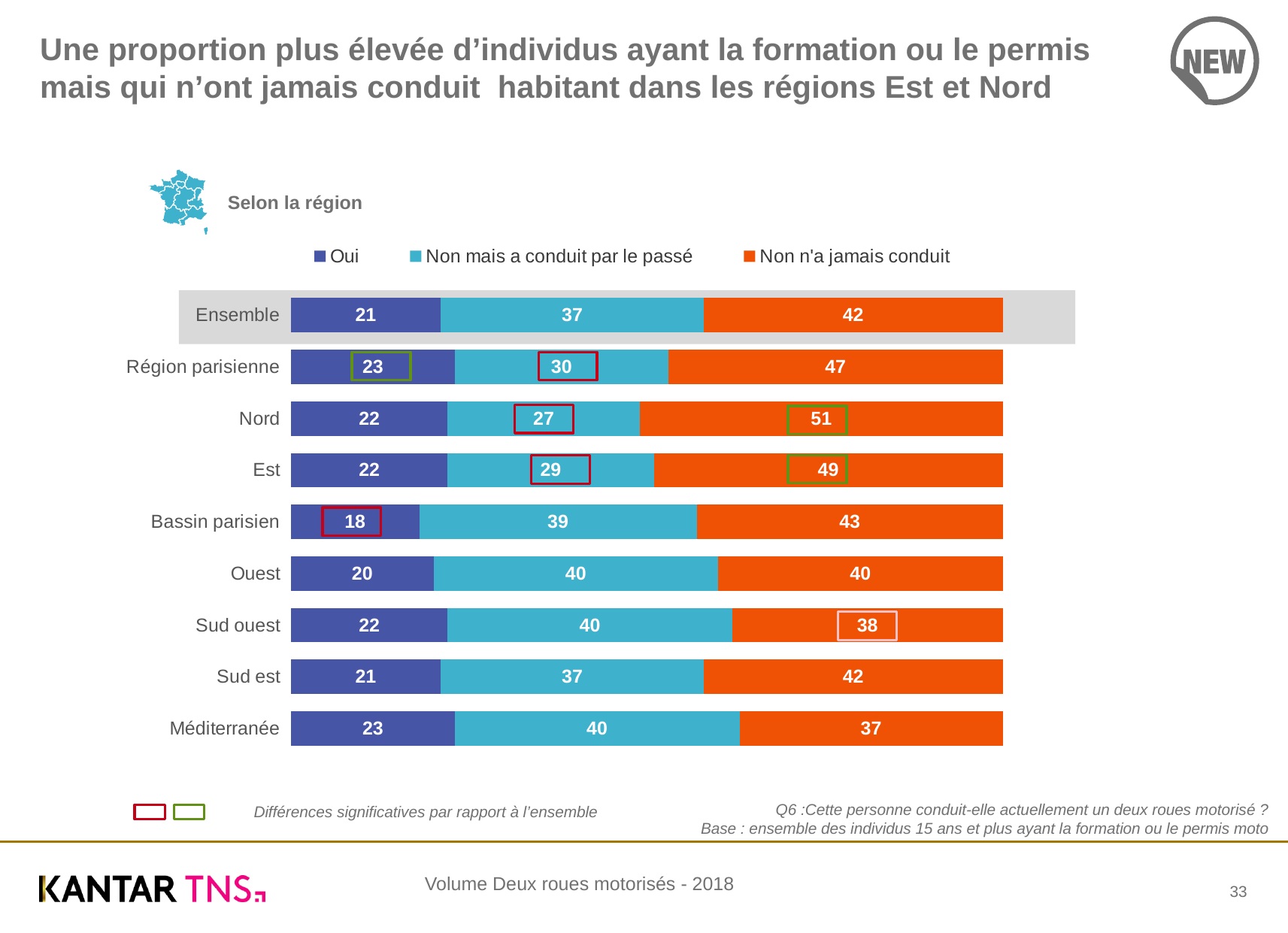
What is the value of "Non n'a jamais conduit" for Nord? 51 Which is larger: the "Non mais a conduit par le passé" value for Est or for Ouest? Ouest What is the value of "Oui" for Bassin parisien? 18 Which region has the highest value for "Non n'a jamais conduit"? Nord What is the total of the stacked bar for Sud ouest? 100 How many regions (categories) are shown in the chart, including Ensemble? 9 What is the difference between the "Non n'a jamais conduit" values for Nord and Méditerranée? 14 Which region has the lowest value for "Oui"? Bassin parisien What is the value of "Non mais a conduit par le passé" for Région parisienne? 30 What kind of chart is shown on the slide? Stacked bar chart How many series does the legend list? 3 Which series is shown in orange in the legend? Non n'a jamais conduit